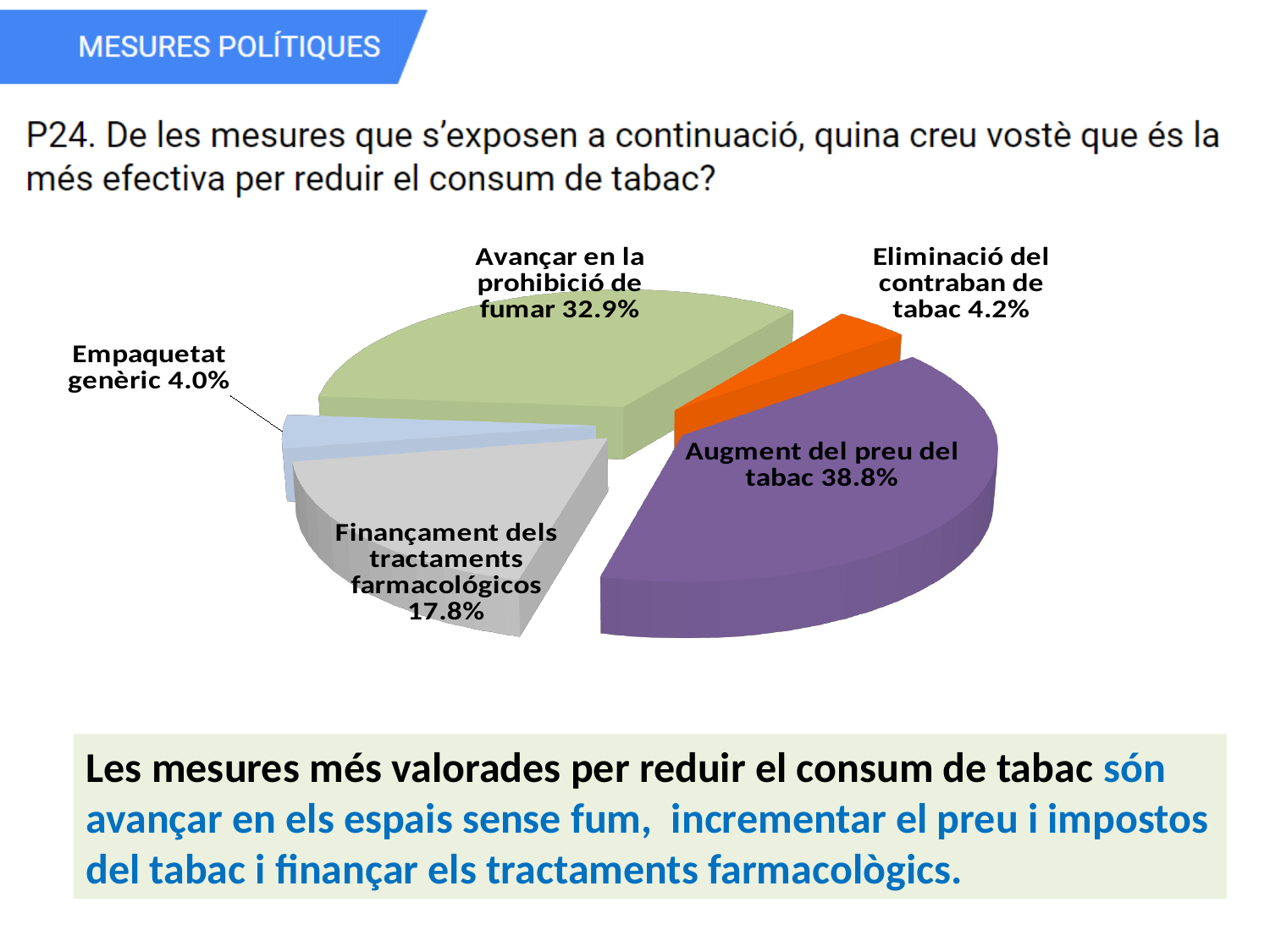
What is the difference in percentage points between 'Augment del preu del tabac' and 'Avançar en la prohibició de fumar'? 5.9 What colour is the slice for 'Augment del preu del tabac'? purple What kind of chart is shown on the slide? pie chart Which measure has the smallest share of the pie? Empaquetat genèric Which is larger: the share for 'Finançament dels tractaments farmacológicos' or the share for 'Eliminació del contraban de tabac'? Finançament dels tractaments farmacológicos What percentage is shown for 'Eliminació del contraban de tabac'? 4.2% What percentage is shown for 'Finançament dels tractaments farmacológicos'? 17.8% Which measure has the largest share of the pie? Augment del preu del tabac How many slices does the pie chart have? 5 What percentage is shown for 'Avançar en la prohibició de fumar'? 32.9% What percentage is shown for 'Augment del preu del tabac'? 38.8% What percentage is shown for 'Empaquetat genèric'? 4.0%